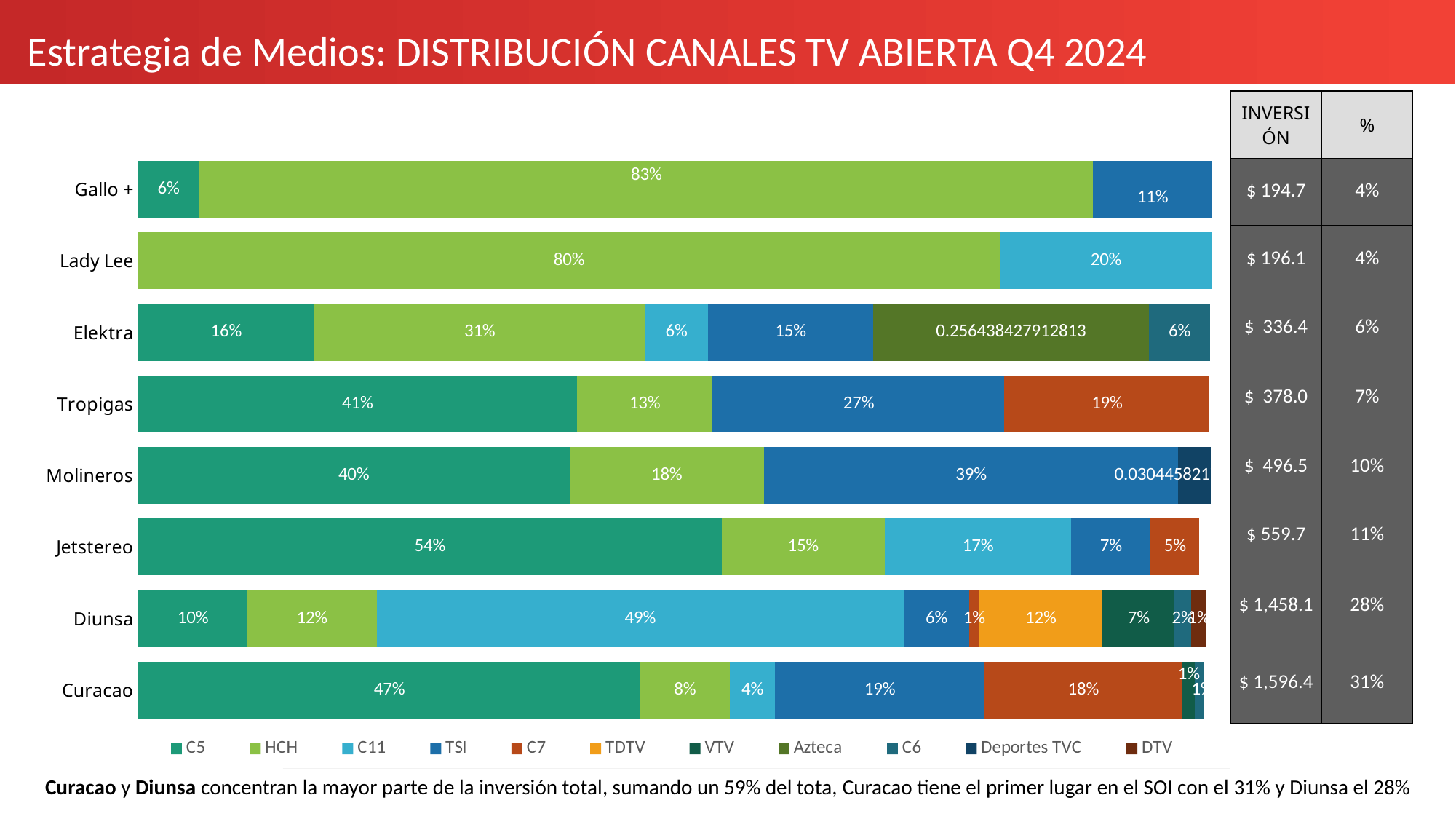
What is the TSI share for Molineros? 39% What is the C11 share for Lady Lee? 20% Which is larger, the C5 share for Jetstereo or the C5 share for Curacao? Jetstereo Which category has the largest C5 share? Jetstereo What percentage of Gallo +'s distribution goes to HCH? 83% What is the C11 share for Diunsa? 49% What kind of chart is shown on the slide? Stacked bar chart What is the C5 share for Jetstereo? 54% How many series does the legend list? 11 Which category has the largest HCH share? Gallo + How many categories (retailers) are shown on the chart? 8 What is the difference in percentage points between the HCH share for Gallo + and the HCH share for Lady Lee? 3 percentage points